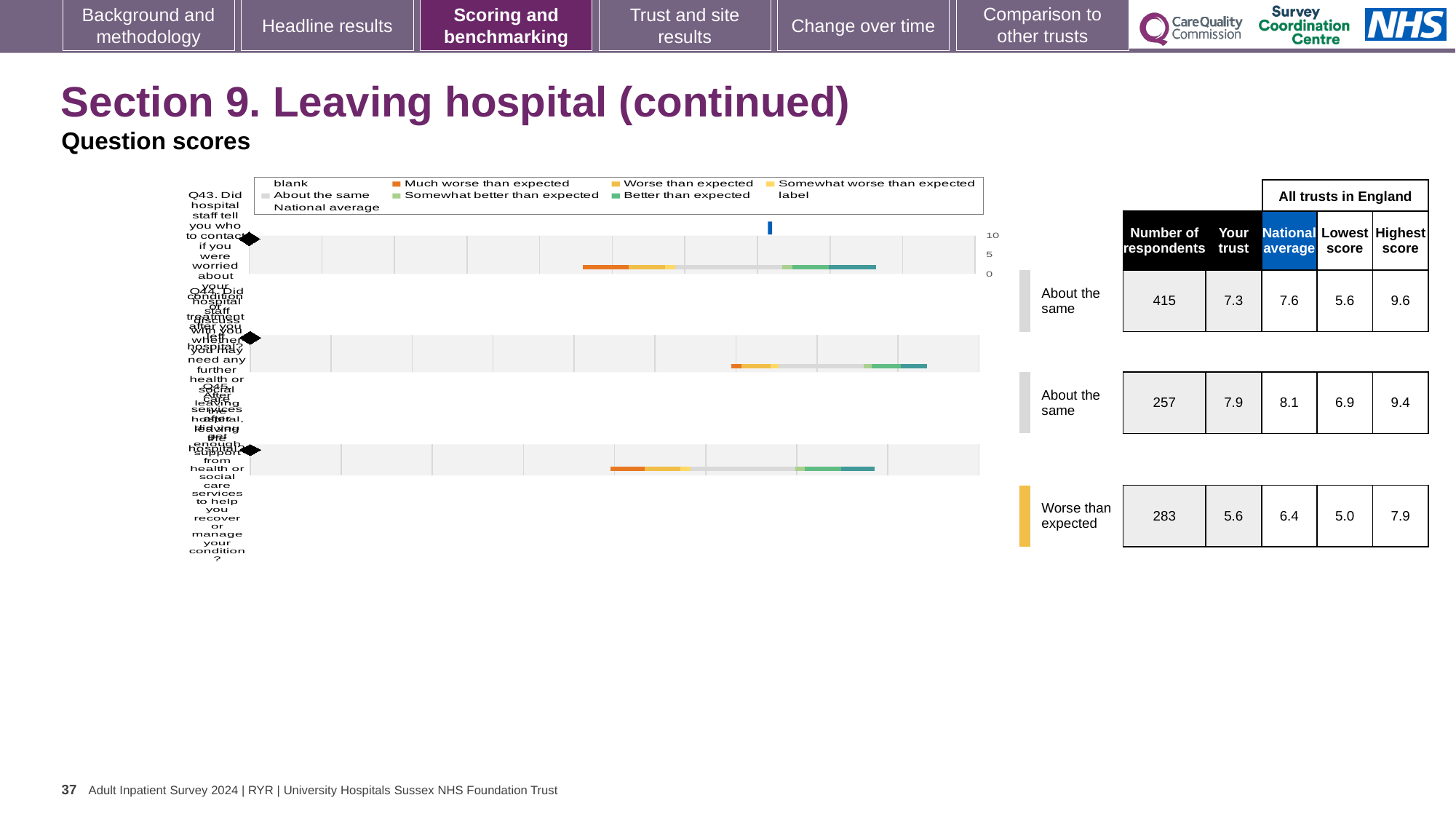
What is the national average for the third (bottom) question row? 6.4 How many question rows are plotted in the benchmarking chart? 3 What is the 'Your trust' score for the first (top) question row? 7.3 What is the lowest score among all trusts in England for the first (top) question row? 5.6 What is the difference between the national average and the 'Your trust' score for the third (bottom) question row? 0.8 Which is larger, the 'Your trust' score for the first row or for the second row? the second row (7.9) What benchmark category is shown for the third (bottom) question row? Worse than expected What is the highest score among all trusts in England for the second (middle) question row? 9.4 What colour represents 'Much worse than expected' in the legend? orange What kind of chart is used to show the question scores? bar chart Which question row has the lowest 'Your trust' score? the third (bottom) row, 5.6 What is the number of respondents for the first (top) question row? 415